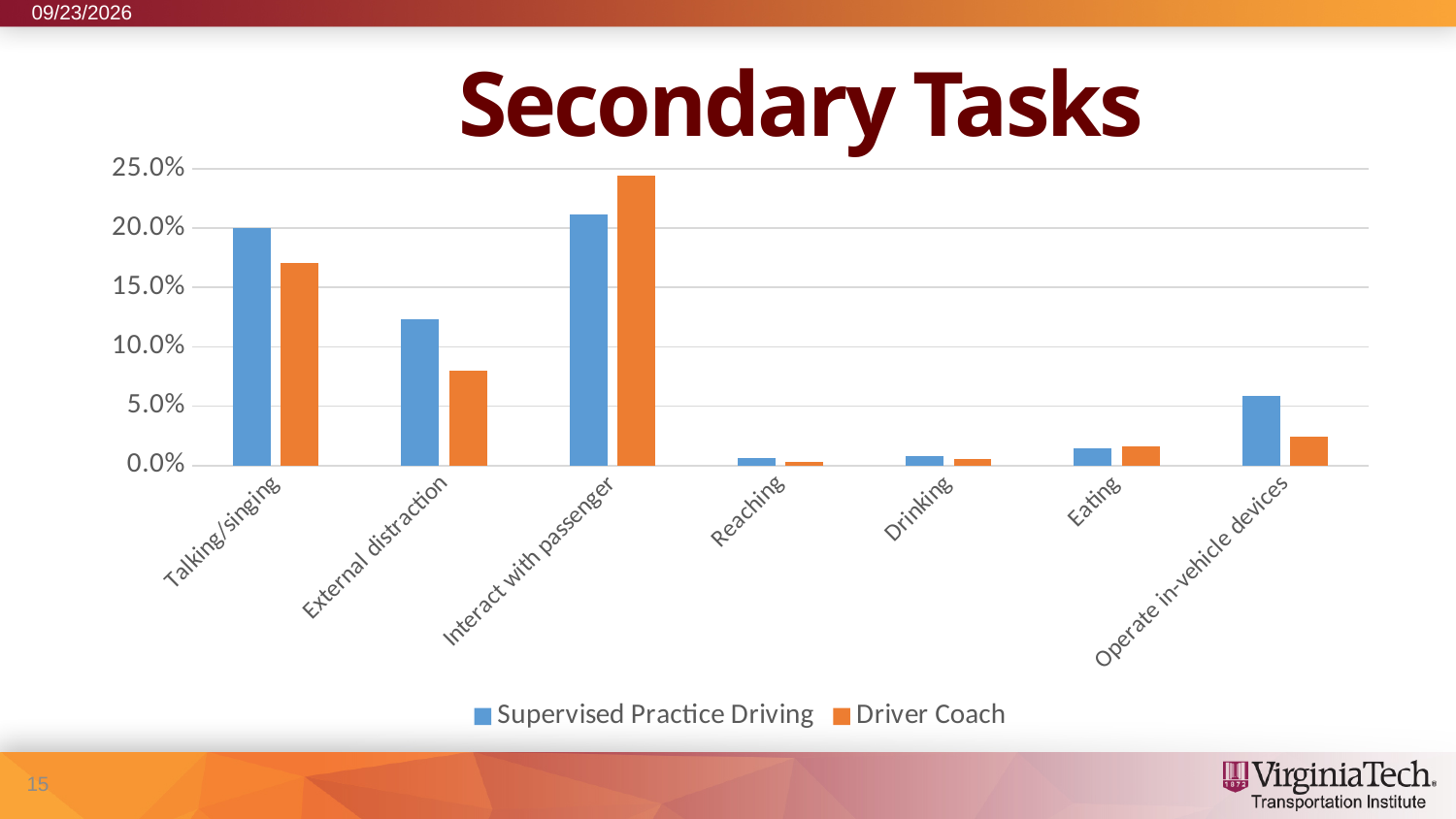
How many series does the legend list? 2 What kind of chart is shown on the slide? Bar chart For Interact with passenger, which series has the larger value, Supervised Practice Driving or Driver Coach? Driver Coach Which colour represents the Driver Coach series? Orange How many secondary task categories are shown on the x axis? 7 Is the Supervised Practice Driving value for Operate in-vehicle devices greater or less than 5.0%? greater Is the Supervised Practice Driving value for Talking/singing greater or less than 15.0%? greater Which category has the highest Driver Coach value? Interact with passenger Is the Driver Coach value for Interact with passenger greater or less than 20.0%? greater What is the title of the chart? Secondary Tasks For Talking/singing, which series has the larger value, Supervised Practice Driving or Driver Coach? Supervised Practice Driving